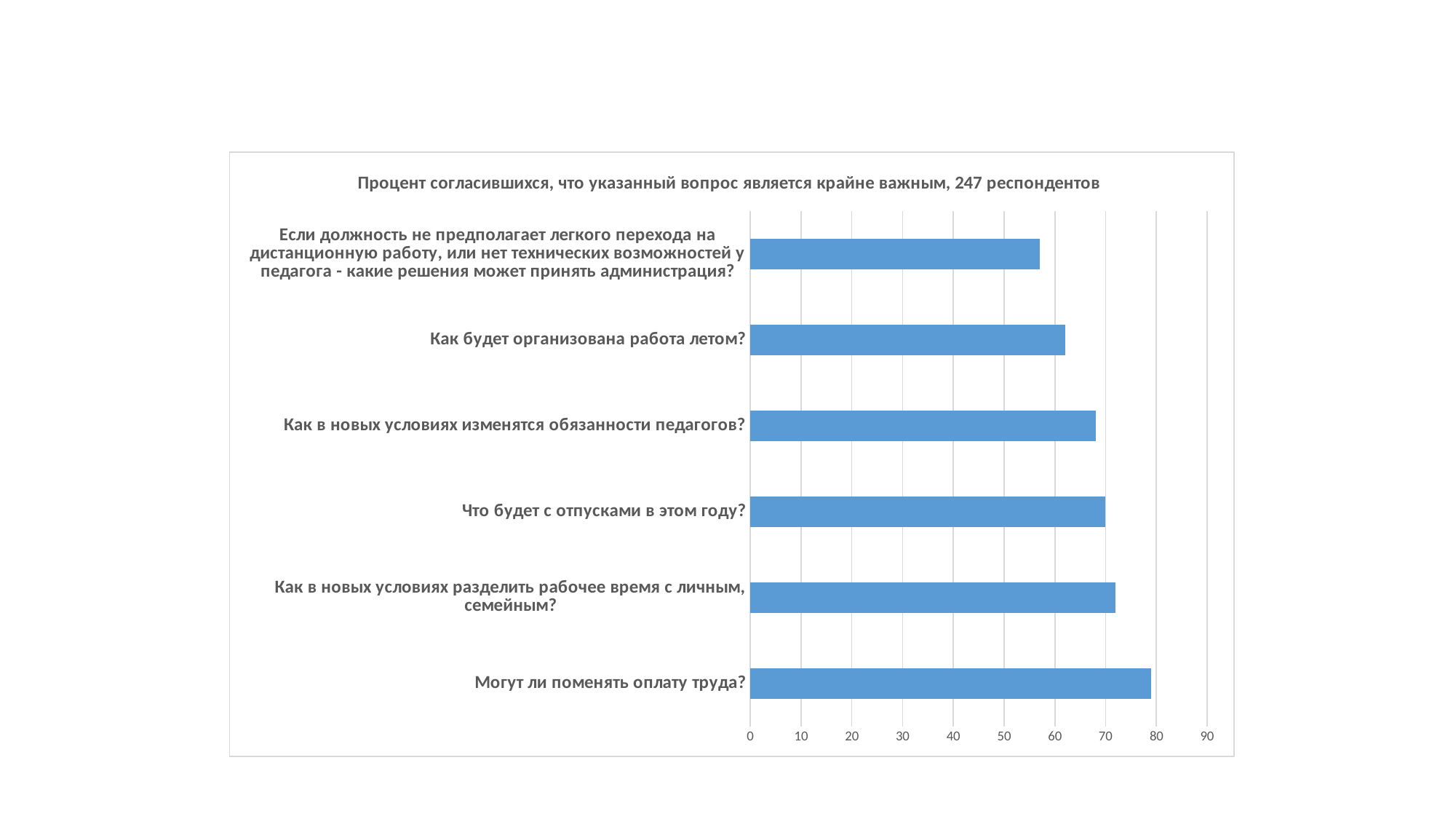
What kind of chart is shown on the slide? Bar chart Which category has the highest value in the chart? Могут ли поменять оплату труда? Which is larger: the value for "Как в новых условиях изменятся обязанности педагогов?" or for "Как будет организована работа летом?" Как в новых условиях изменятся обязанности педагогов? Is the value for "Могут ли поменять оплату труда?" greater or less than 70? greater What is the maximum value shown on the horizontal axis of the chart? 90 Is the value for "Как в новых условиях разделить рабочее время с личным, семейным?" greater or less than 60? greater Is the value for "Если должность не предполагает легкого перехода на дистанционную работу, или нет технических возможностей у педагога - какие решения может принять администрация?" greater or less than 50? greater Which is larger: the value for "Могут ли поменять оплату труда?" or for "Как будет организована работа летом?" Могут ли поменять оплату труда? What is the title of the chart? Процент согласившихся, что указанный вопрос является крайне важным, 247 респондентов How many categories (questions) are plotted in the chart? 6 Which category has the lowest value in the chart? Если должность не предполагает легкого перехода на дистанционную работу, или нет технических возможностей у педагога - какие решения может принять администрация?